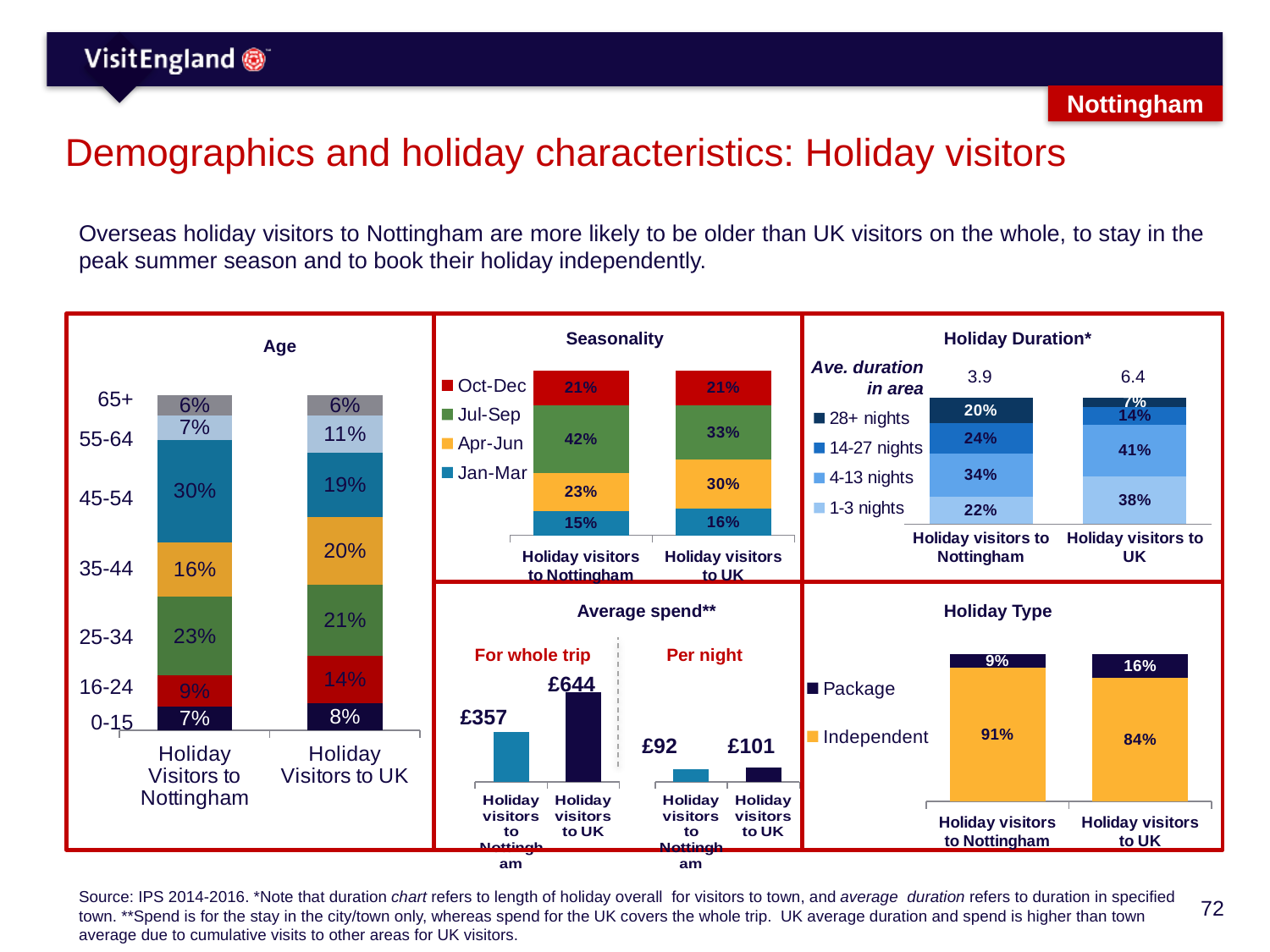
In the Age chart, what share of holiday visitors to Nottingham are aged 45-54? 30% In the Seasonality chart, how many series does the legend list? 4 In the Average spend chart, what is the difference in per night spend between holiday visitors to UK and holiday visitors to Nottingham? £9 In the Age chart, which age group is the largest for holiday visitors to UK? 25-34 In the Seasonality chart, which is larger: the Apr-Jun share for holiday visitors to Nottingham or for holiday visitors to UK? Holiday visitors to UK What kind of chart is the Holiday Type chart? Stacked bar chart In the Average spend chart, what is the average spend for the whole trip for holiday visitors to UK? £644 In the Age chart, what is the difference between the 16-24 share for holiday visitors to UK and for holiday visitors to Nottingham? 5% In the Holiday Type chart, what share of holiday visitors to Nottingham book a package holiday? 9% In the Holiday Duration chart, what is the average duration in area for holiday visitors to Nottingham? 3.9 In the Seasonality chart, what share of holiday visitors to Nottingham visit in Jul-Sep? 42% In the Holiday Duration chart, what share of holiday visitors to UK stay 4-13 nights? 41%